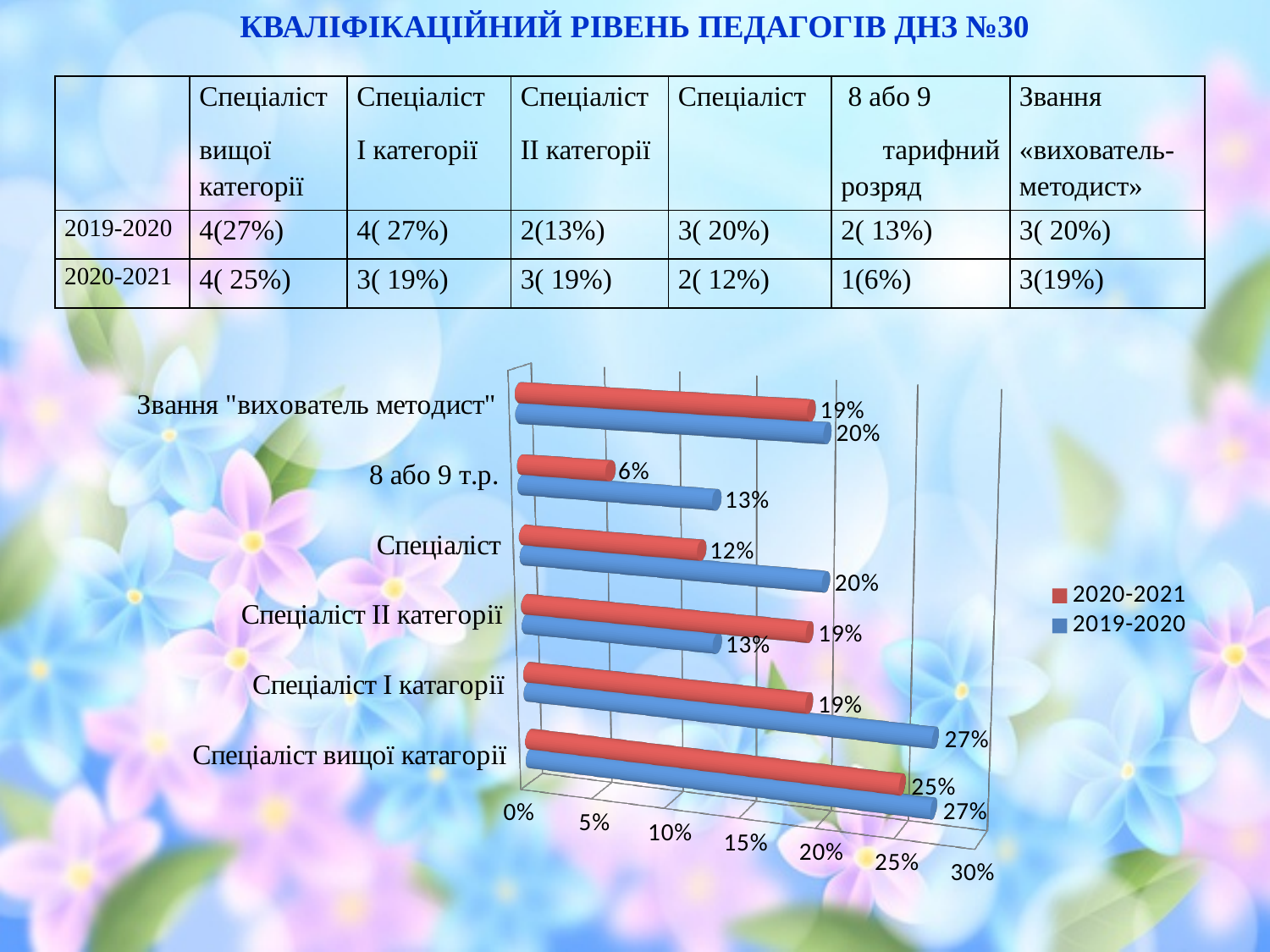
What is the 2020-2021 value for "8 або 9 т.р." on the chart? 6% What is the difference between the 2019-2020 and 2020-2021 values for "Спеціаліст I катагорії"? 8% What is the 2020-2021 value for "Спеціаліст вищої катагорії" on the chart? 25% What is the difference between the 2019-2020 and 2020-2021 values for "8 або 9 т.р."? 7% What is the 2019-2020 value for "Спеціаліст" on the chart? 20% How many series does the chart legend list? 2 For "Спеціаліст II категорії", which series has the larger value, 2020-2021 or 2019-2020? 2020-2021 What type of chart is shown on the slide? bar chart Which colour represents the 2019-2020 series in the chart? blue How many categories are plotted on the chart? 6 Which category has the lowest 2020-2021 value on the chart? 8 або 9 т.р. Which category has the highest 2020-2021 value on the chart? Спеціаліст вищої катагорії